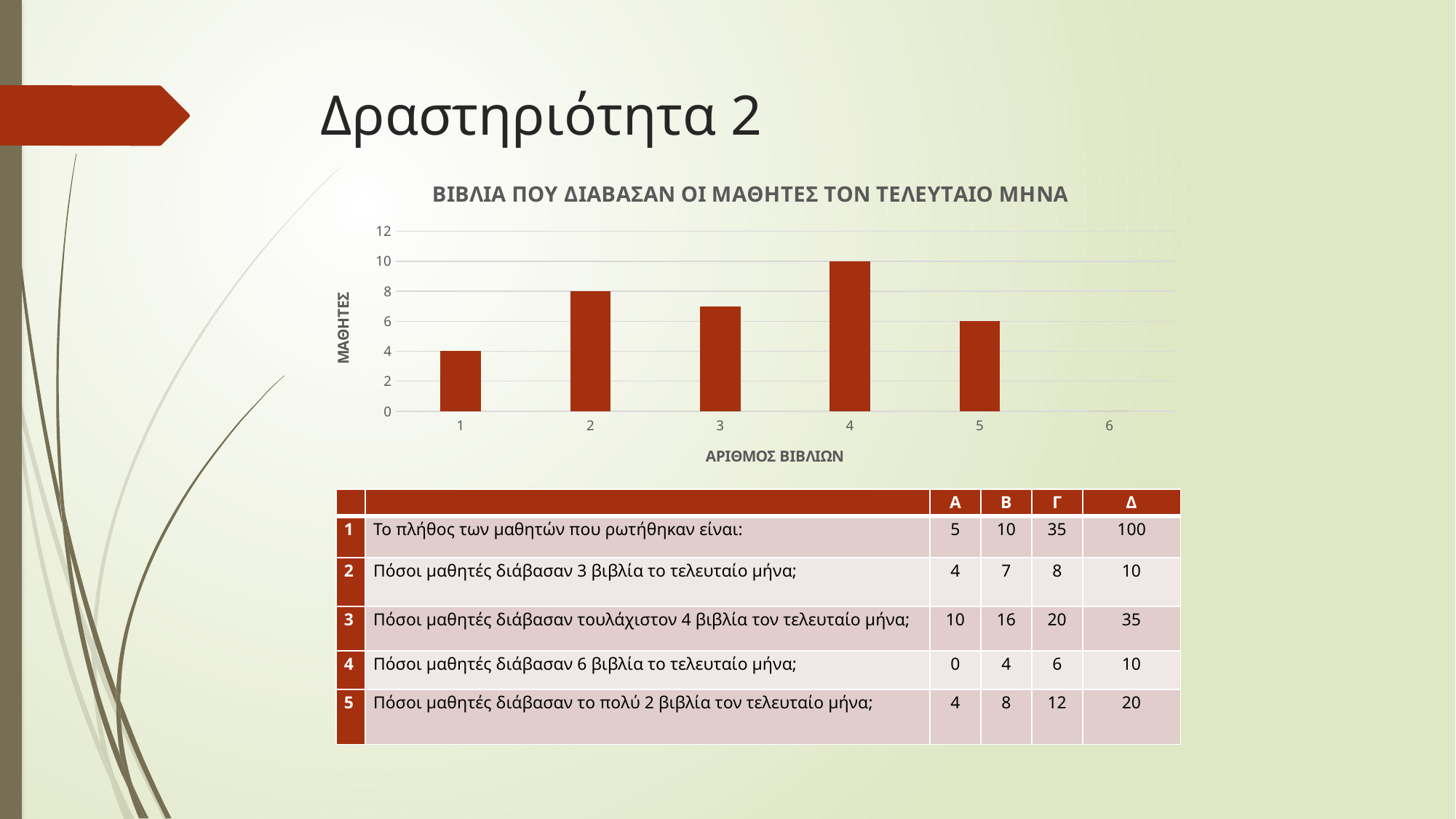
What is the value (ΜΑΘΗΤΕΣ) for category 4 on the chart? 10 Which category has the lowest value on the chart? 6 What is the value (ΜΑΘΗΤΕΣ) for category 1 on the chart? 4 What kind of chart is shown on the slide? bar chart How many categories are shown on the x axis of the chart? 6 What is the value (ΜΑΘΗΤΕΣ) for category 2 on the chart? 8 What is the difference between the values for category 4 and category 1? 6 What is the title of the chart? ΒΙΒΛΙΑ ΠΟΥ ΔΙΑΒΑΣΑΝ ΟΙ ΜΑΘΗΤΕΣ ΤΟΝ ΤΕΛΕΥΤΑΙΟ ΜΗΝΑ What is the value (ΜΑΘΗΤΕΣ) for category 6 on the chart? 0 Which category has the highest value on the chart? 4 What is the value (ΜΑΘΗΤΕΣ) for category 5 on the chart? 6 Is the value for category 3 greater or less than 6? greater